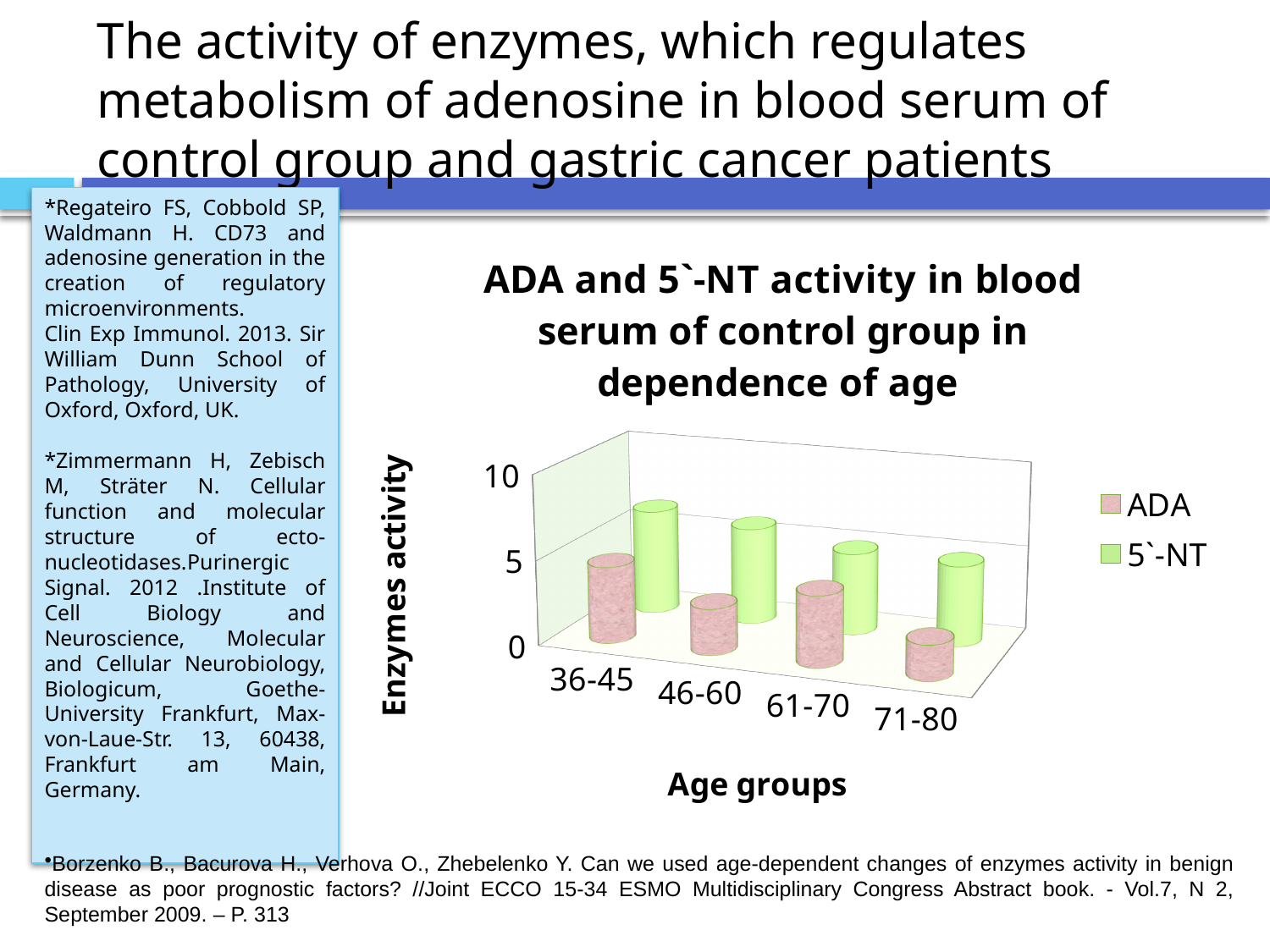
Which age group has the highest ADA activity? 36-45 What kind of chart is shown on the slide? bar chart Is the 5`-NT activity for the 36-45 age group greater or less than 5? greater Which age group has the lowest ADA activity? 71-80 How many series does the chart legend list? 2 How many age groups are shown on the x axis of the chart? 4 Is the ADA activity for the 71-80 age group greater or less than 5? less What is the label of the vertical axis of the chart? Enzymes activity Does 5`-NT activity rise or fall across the age groups from 36-45 to 71-80? fall Which age group has the highest 5`-NT activity? 36-45 For the 36-45 age group, which is larger: ADA or 5`-NT activity? 5`-NT Is the 5`-NT activity for the 36-45 age group greater or less than 10? less